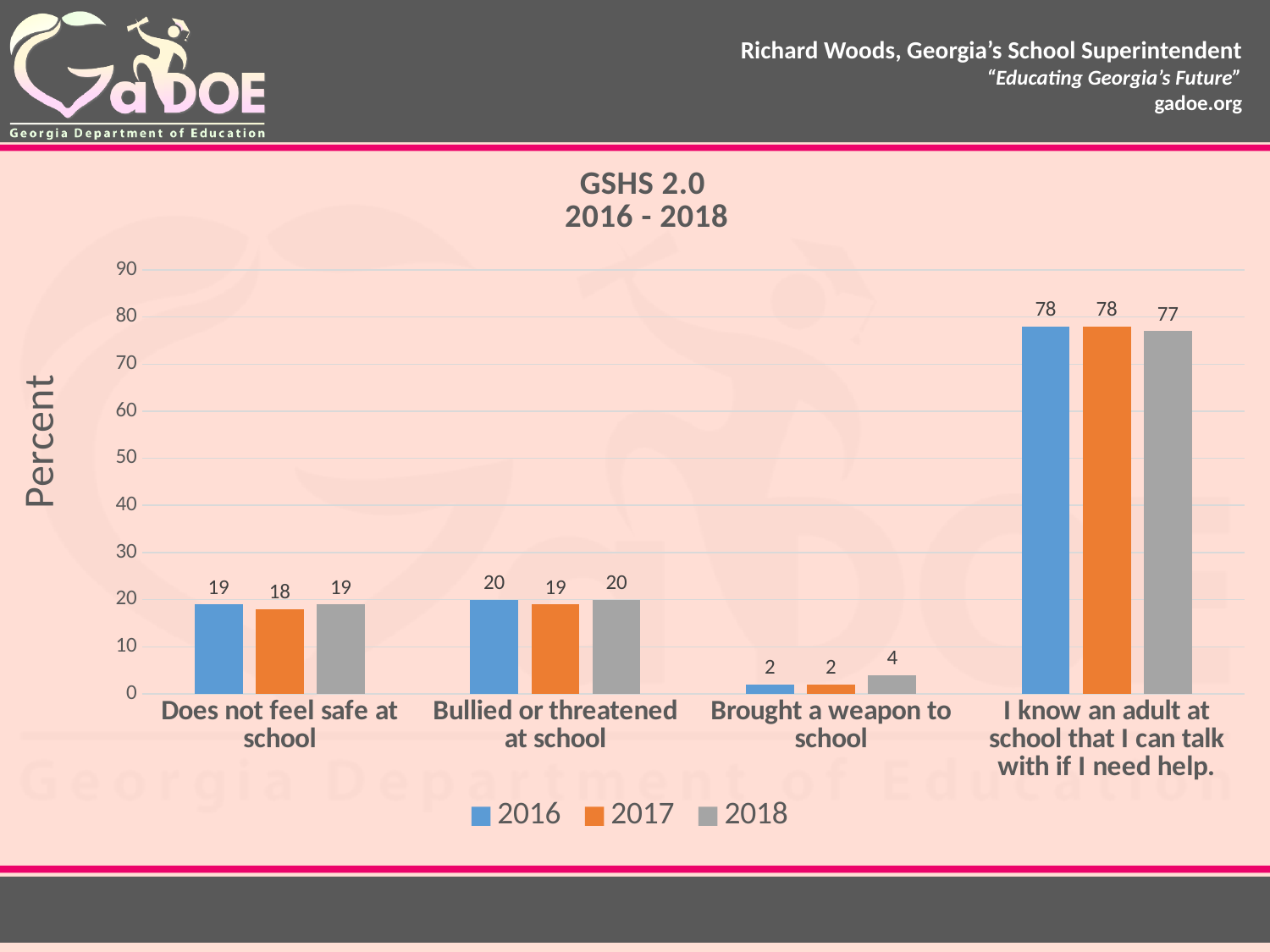
How many series does the legend list? 3 Which category has the lowest 2016 value? Brought a weapon to school Which category has the highest 2018 value? I know an adult at school that I can talk with if I need help. What is the 2017 value for "I know an adult at school that I can talk with if I need help."? 78 What kind of chart is shown on the slide? Bar chart What is the 2016 value for "Does not feel safe at school"? 19 Which is larger for "Does not feel safe at school": the 2016 value or the 2017 value? 2016 What is the label of the y axis? Percent What is the difference between the 2018 and 2016 values for "Brought a weapon to school"? 2 What is the 2018 value for "Brought a weapon to school"? 4 What is the 2017 value for "Bullied or threatened at school"? 19 How many categories are shown on the x axis? 4